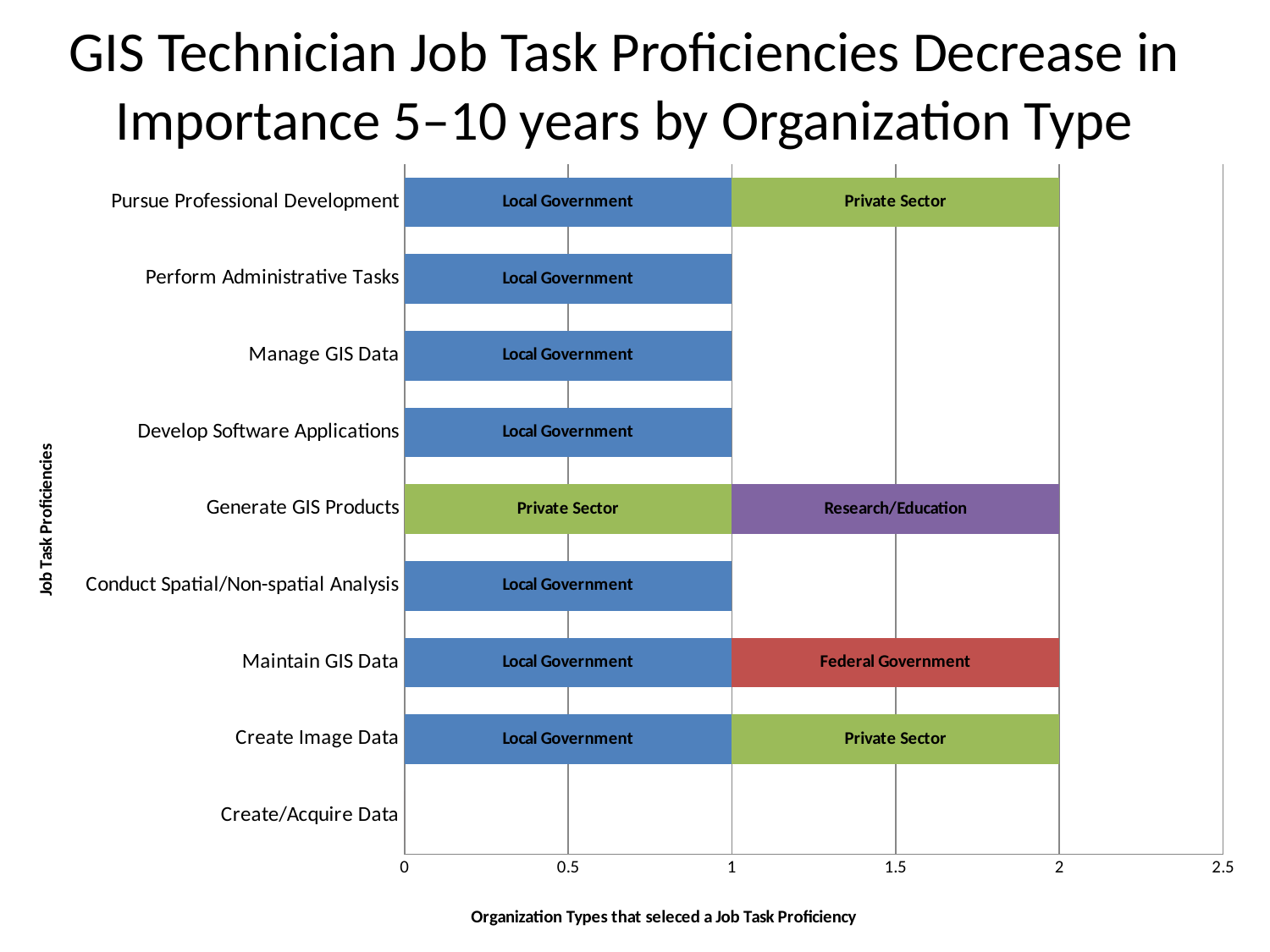
How many job task proficiencies are listed on the vertical axis? 9 Which has the larger total bar: Maintain GIS Data or Manage GIS Data? Maintain GIS Data What is the difference between the total for Create Image Data and the total for Perform Administrative Tasks? 1 What is the title of the horizontal axis? Organization Types that seleced a Job Task Proficiency What is the total length of the stacked bar for Conduct Spatial/Non-spatial Analysis? 1 What is the value of the Federal Government segment for Maintain GIS Data? 1 Is the total for Pursue Professional Development greater or less than 1.5? greater What is the value of the Local Government segment for Maintain GIS Data? 1 What kind of chart is shown on the slide? bar chart Which organization types are shown in the bar for Generate GIS Products? Private Sector and Research/Education Which job task proficiency has the lowest total, with no bar shown at all? Create/Acquire Data What is the total length of the stacked bar for Pursue Professional Development? 2